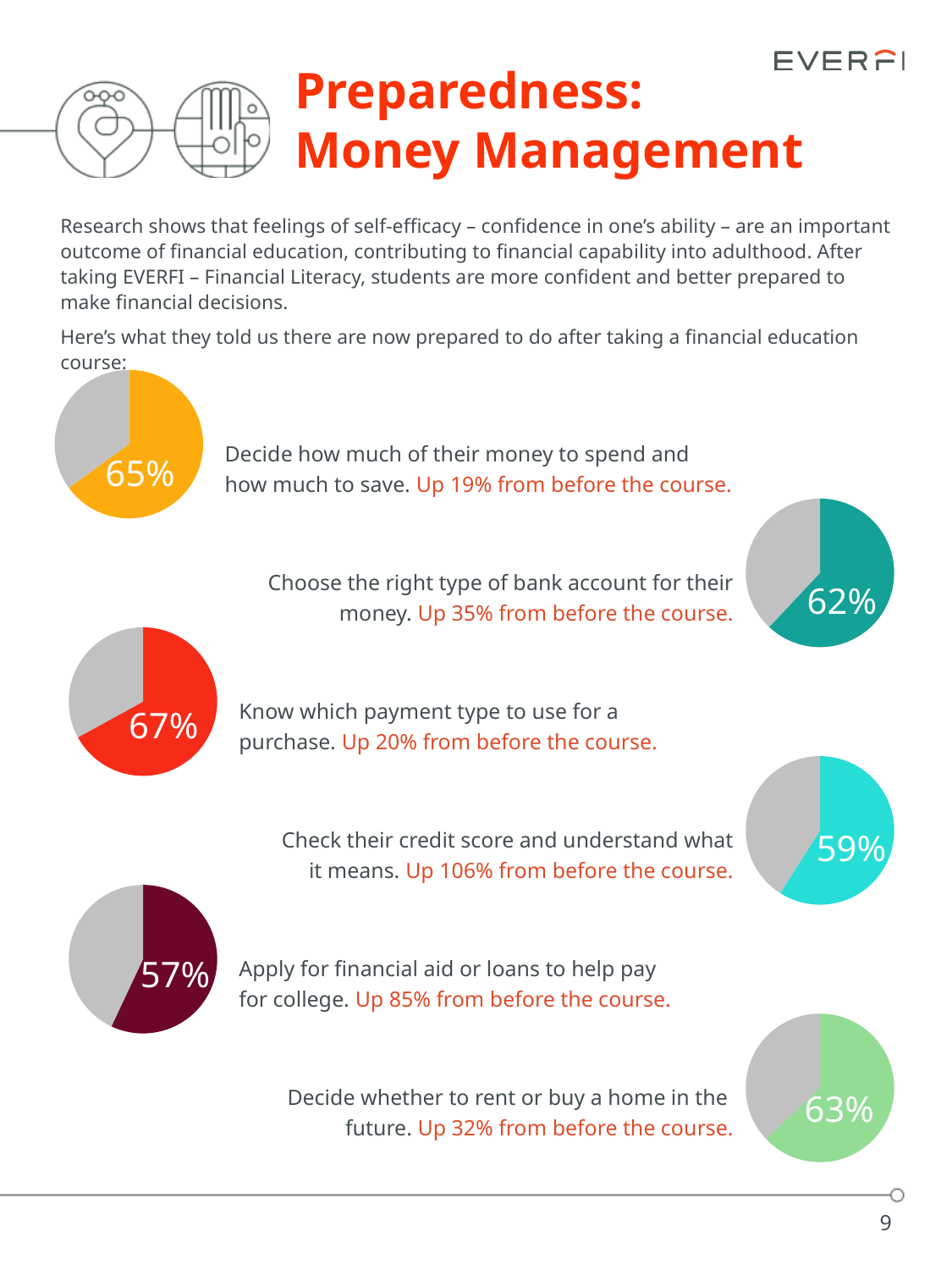
Across all the pie charts on the slide, which item has the lowest percentage? Apply for financial aid or loans to help pay for college (57%) Which is larger: the percentage in the "Decide how much of their money to spend and how much to save" pie chart or the percentage in the "Decide whether to rent or buy a home in the future" pie chart? Decide how much of their money to spend and how much to save (65%) In the pie chart next to "Apply for financial aid or loans to help pay for college", what percentage is shown? 57% In the pie chart next to "Know which payment type to use for a purchase", what percentage is shown? 67% How many pie charts are shown on the slide? 6 In the pie chart next to "Choose the right type of bank account for their money", what percentage is shown? 62% In the pie chart next to "Decide whether to rent or buy a home in the future", what percentage is shown? 63% What is the difference between the percentage in the "Know which payment type to use for a purchase" pie chart and the percentage in the "Apply for financial aid or loans" pie chart? 10% In the pie chart next to "Check their credit score and understand what it means", what percentage is shown? 59% What type of chart is used to show each percentage on the slide? Pie chart Across all the pie charts on the slide, which item has the highest percentage? Know which payment type to use for a purchase (67%) In the pie chart next to "Decide how much of their money to spend and how much to save", what percentage is shown? 65%